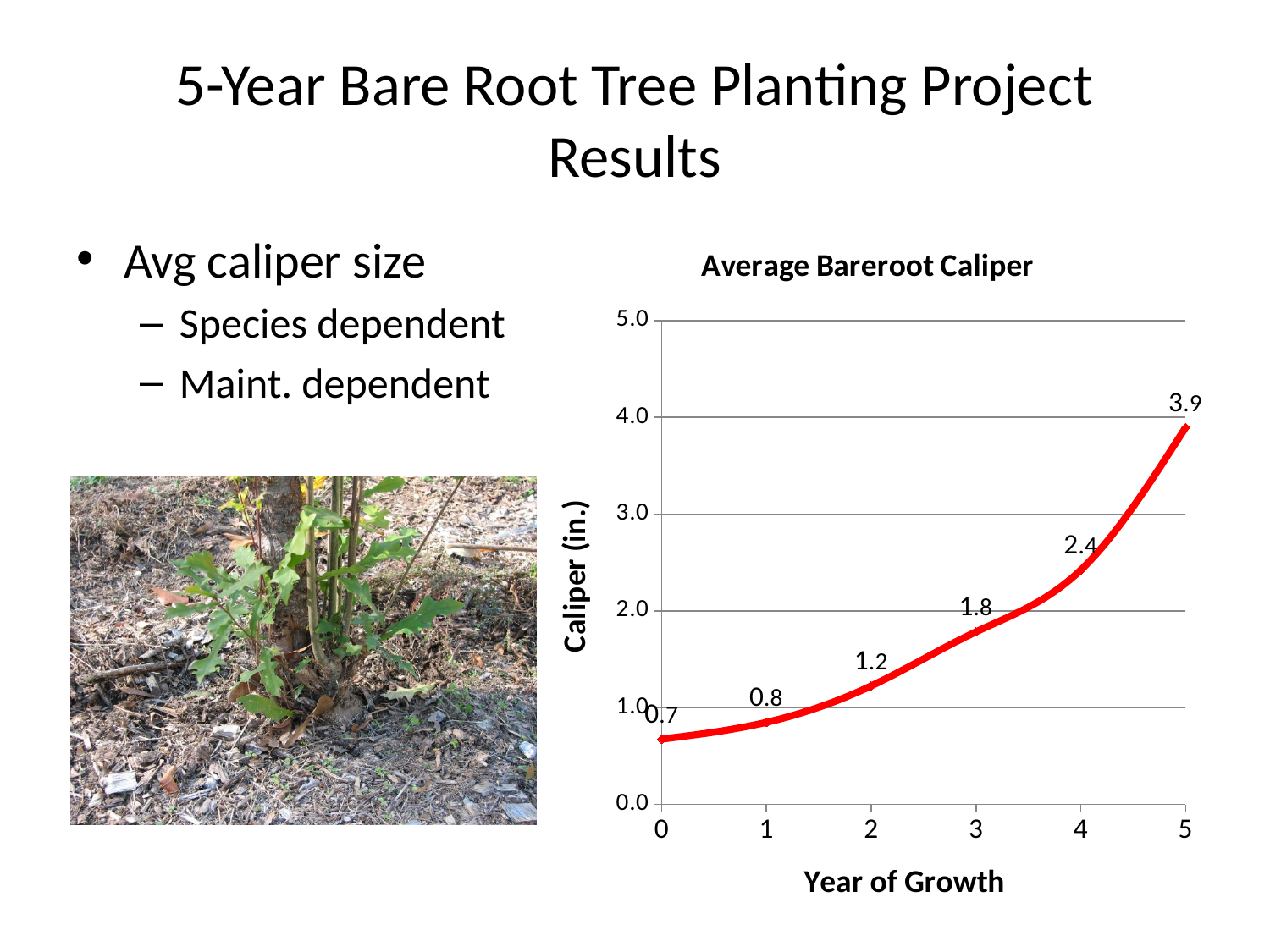
What is the difference in caliper between year 5 and year 4? 1.5 What is the average caliper at year 3? 1.8 What is the title of the chart? Average Bareroot Caliper What is the average caliper at year 5? 3.9 At which year of growth is the caliper highest? 5 Which has a larger caliper, year 2 or year 4? year 4 Does the caliper rise or fall as the year of growth increases? rise Is the caliper at year 4 greater or less than 2.0? greater At which year of growth is the caliper lowest? 0 How many data points are plotted on the line? 6 What is the average caliper at year 0? 0.7 What type of chart is shown on the slide? line chart